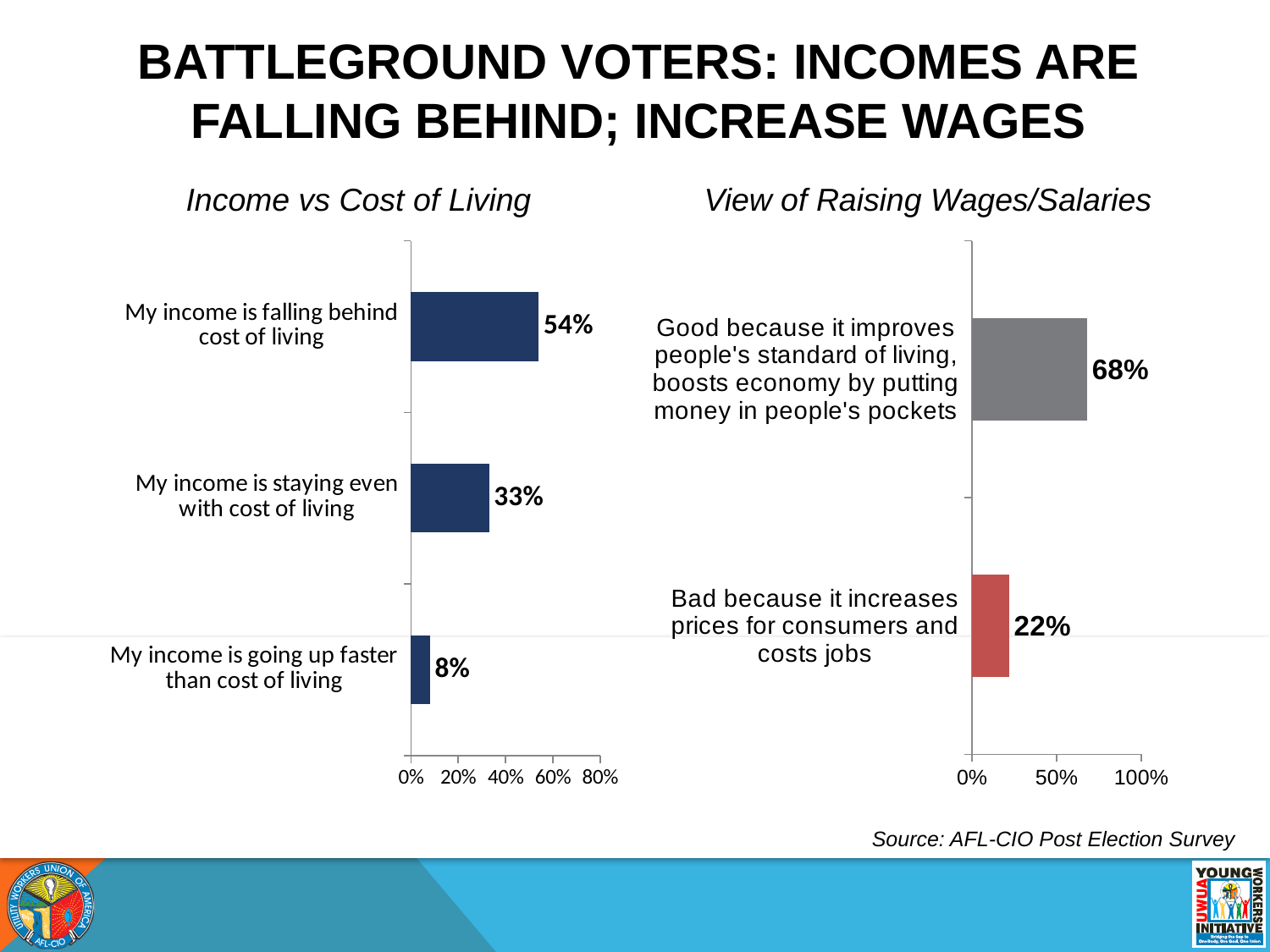
In the 'View of Raising Wages/Salaries' chart, which category has the highest value? Good because it improves people's standard of living, boosts economy by putting money in people's pockets In the 'Income vs Cost of Living' chart, what percentage of voters say their income is falling behind cost of living? 54% In the 'View of Raising Wages/Salaries' chart, what is the difference between the 'Good' and 'Bad' values? 46% What type of chart is the 'Income vs Cost of Living' chart? Bar chart In the 'Income vs Cost of Living' chart, what is the difference between 'falling behind' and 'staying even'? 21% In the 'View of Raising Wages/Salaries' chart, what is the value for 'Bad because it increases prices for consumers and costs jobs'? 22% In the 'Income vs Cost of Living' chart, how many categories are shown? 3 In the 'Income vs Cost of Living' chart, what is the value for 'My income is staying even with cost of living'? 33% In the 'View of Raising Wages/Salaries' chart, is the value for 'Good' greater or less than 50%? greater In the 'Income vs Cost of Living' chart, which category has the lowest value? My income is going up faster than cost of living What is the source cited for the data on the slide? AFL-CIO Post Election Survey In the 'View of Raising Wages/Salaries' chart, what percentage say raising wages is good? 68%